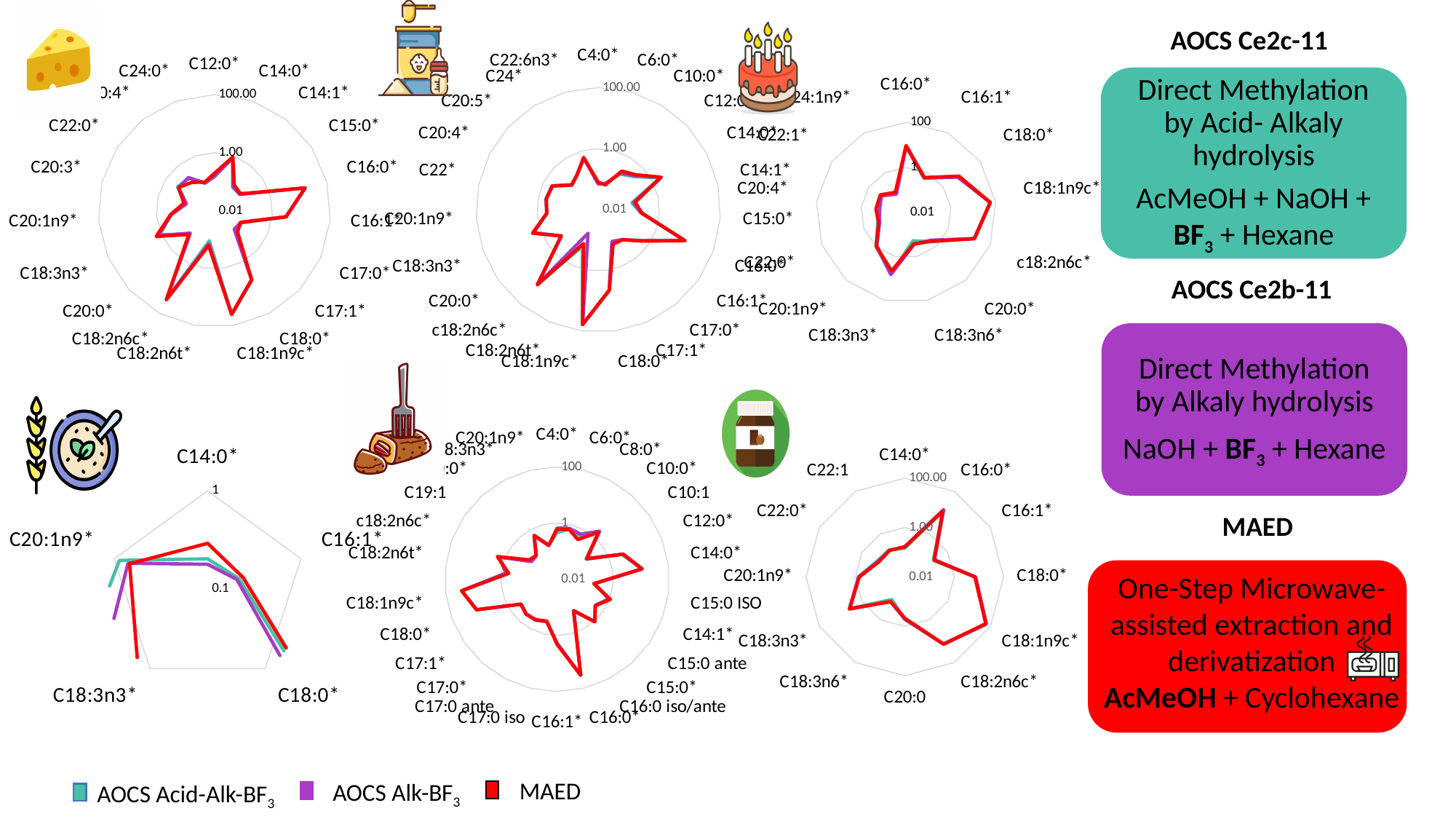
How many series does the legend at the bottom of the slide list? 3 In the bottom-right chart (next to the jar icon), is the MAED value for C18:1n9c greater or less than 1.00? greater In the top-left chart (next to the cheese icon), is the MAED value for C18:1n9c greater or less than 1.00? greater In the top-right chart (next to the cake icon), is the MAED value for C18:1n9c greater or less than 1? greater What kind of chart is used in the top-left chart (next to the cheese icon)? Radar chart How many radar charts are shown on the slide? 6 Which series in the legend is drawn in purple? AOCS Alk-BF3 What value is printed at the outermost ring of the top-left chart (next to the cheese icon)? 100.00 Which series in the legend is drawn in red? MAED